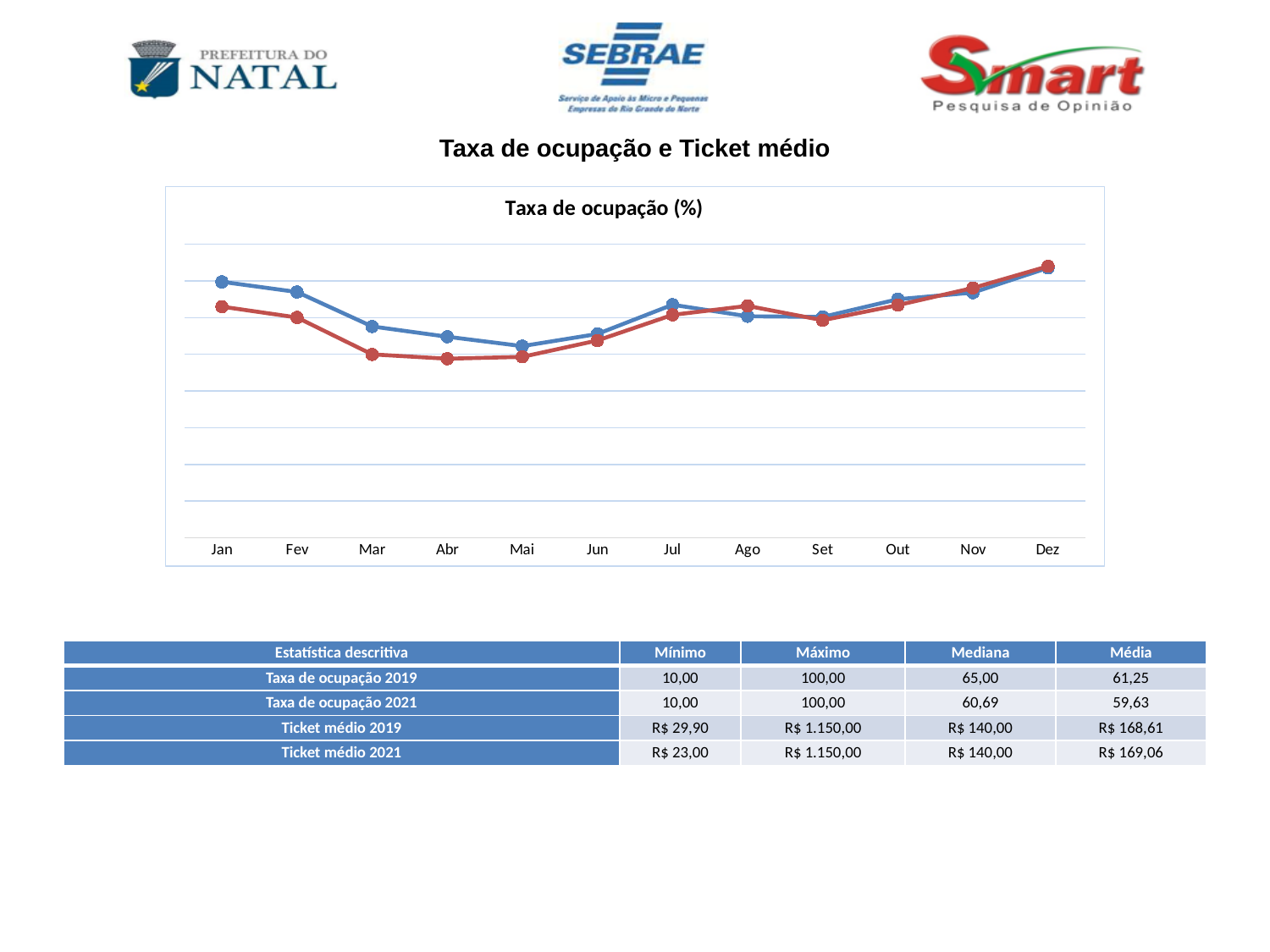
In Mar, which line has the higher value, the blue or the red? Blue In which month does the red line reach its highest value? Dez In which month does the blue line reach its highest value? Dez What colours are the two lines in the chart? Blue and red Does the blue line rise or fall from Jan to Mar? Fall What kind of chart is shown on the slide? Line chart In Jan, which line has the higher value, the blue or the red? Blue In which month does the blue line reach its lowest value? Mai How many lines are plotted in the chart? 2 Does the red line rise or fall from Set to Dez? Rise How many months are shown on the x axis of the chart? 12 What is the title of the chart? Taxa de ocupação (%)